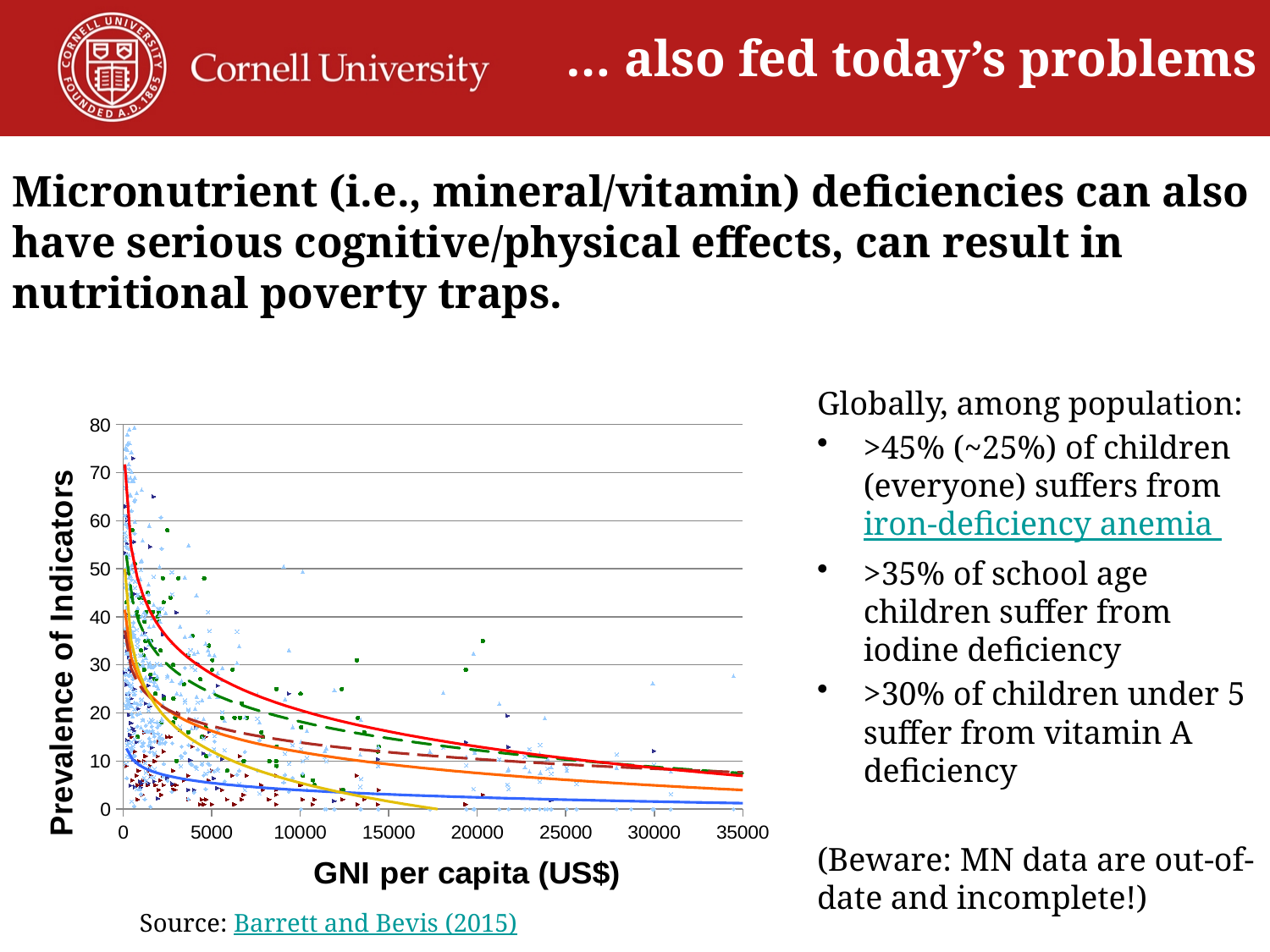
Is the starting value of the red curve near a GNI per capita of 0 greater or less than 60? greater Does the yellow curve reach a prevalence of 0 before or after a GNI per capita of 20000? before What is the label of the horizontal axis of the chart? GNI per capita (US$) Which curve starts at the highest prevalence near a GNI per capita of 0, the red curve or the blue curve? the red curve How many fitted curves are drawn on the chart? 6 What is the label of the vertical axis of the chart? Prevalence of Indicators What is the highest value shown on the horizontal axis of the chart? 35000 What is the highest value shown on the vertical axis of the chart? 80 What kind of chart is shown on the slide? scatter plot Do the fitted curves rise or fall as GNI per capita increases? fall Is the value of the red curve at a GNI per capita of 35000 greater or less than 10? less